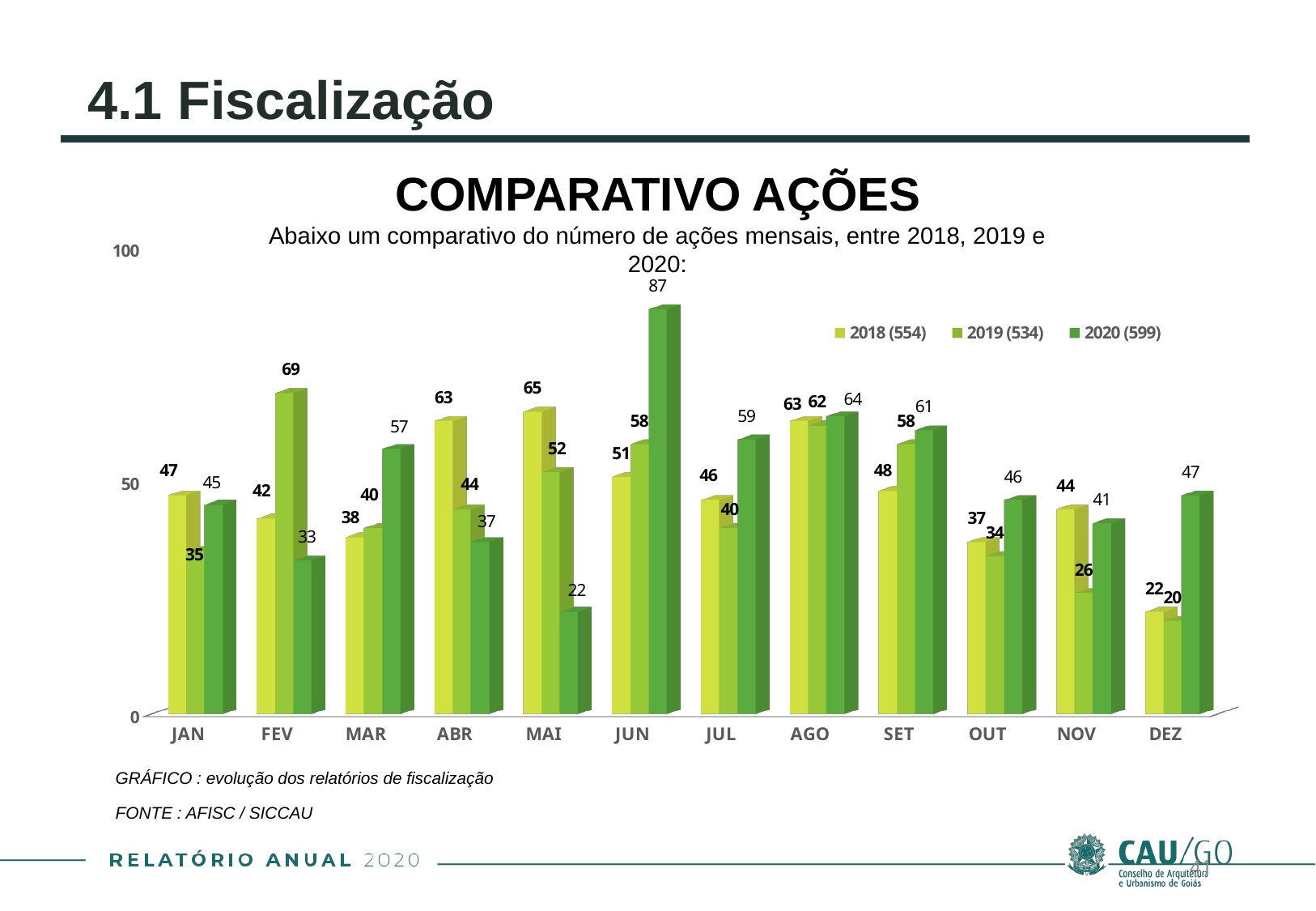
What kind of chart is shown on the slide? Bar chart What is the value for 2020 in JUN? 87 What total is shown in the legend for the 2020 series? 599 How many series does the legend list? 3 How many months are shown on the x axis? 12 Which month has the highest value for the 2020 series? JUN What is the difference between the 2020 and 2018 values in JUN? 36 What is the difference between the 2019 and 2020 values in FEV? 36 Which is larger in MAI, the 2018 value or the 2020 value? 2018 What is the value for 2018 in MAI? 65 What is the value for 2019 in FEV? 69 Which month has the lowest value for the 2019 series? DEZ